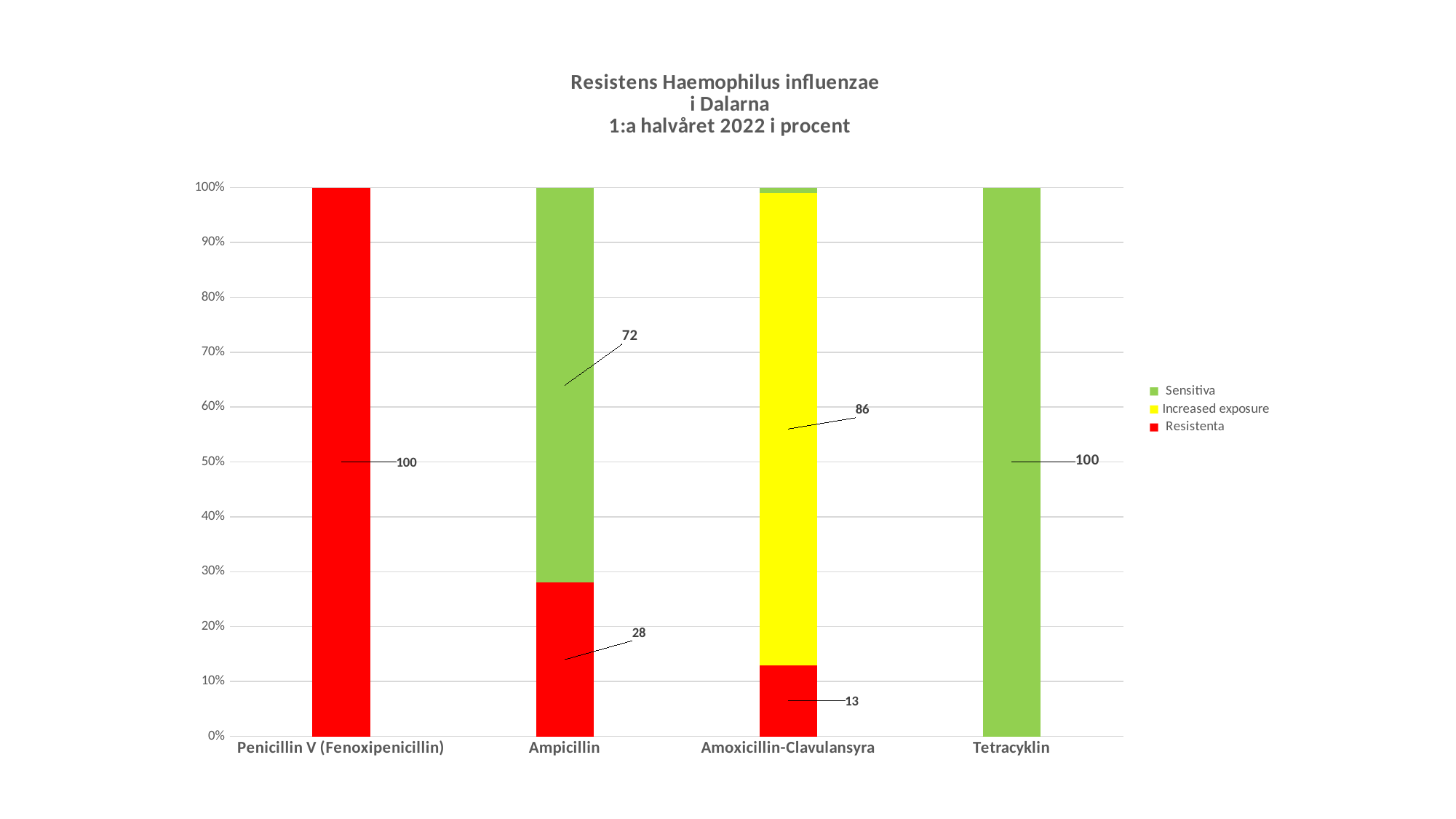
What is the difference between the Sensitiva and Resistenta values for Ampicillin? 44 Is the Sensitiva value for Amoxicillin-Clavulansyra greater or less than 10%? less How many antibiotics are shown on the x axis? 4 What is the Sensitiva value for Tetracyklin? 100 What is the Sensitiva value for Ampicillin? 72 What is the Resistenta value for Penicillin V (Fenoxipenicillin)? 100 Which antibiotic has the highest Resistenta value? Penicillin V (Fenoxipenicillin) What is the Increased exposure value for Amoxicillin-Clavulansyra? 86 What is the Resistenta value for Amoxicillin-Clavulansyra? 13 What is the Resistenta value for Ampicillin? 28 Which has the larger Resistenta value, Ampicillin or Amoxicillin-Clavulansyra? Ampicillin How many series does the legend list? 3